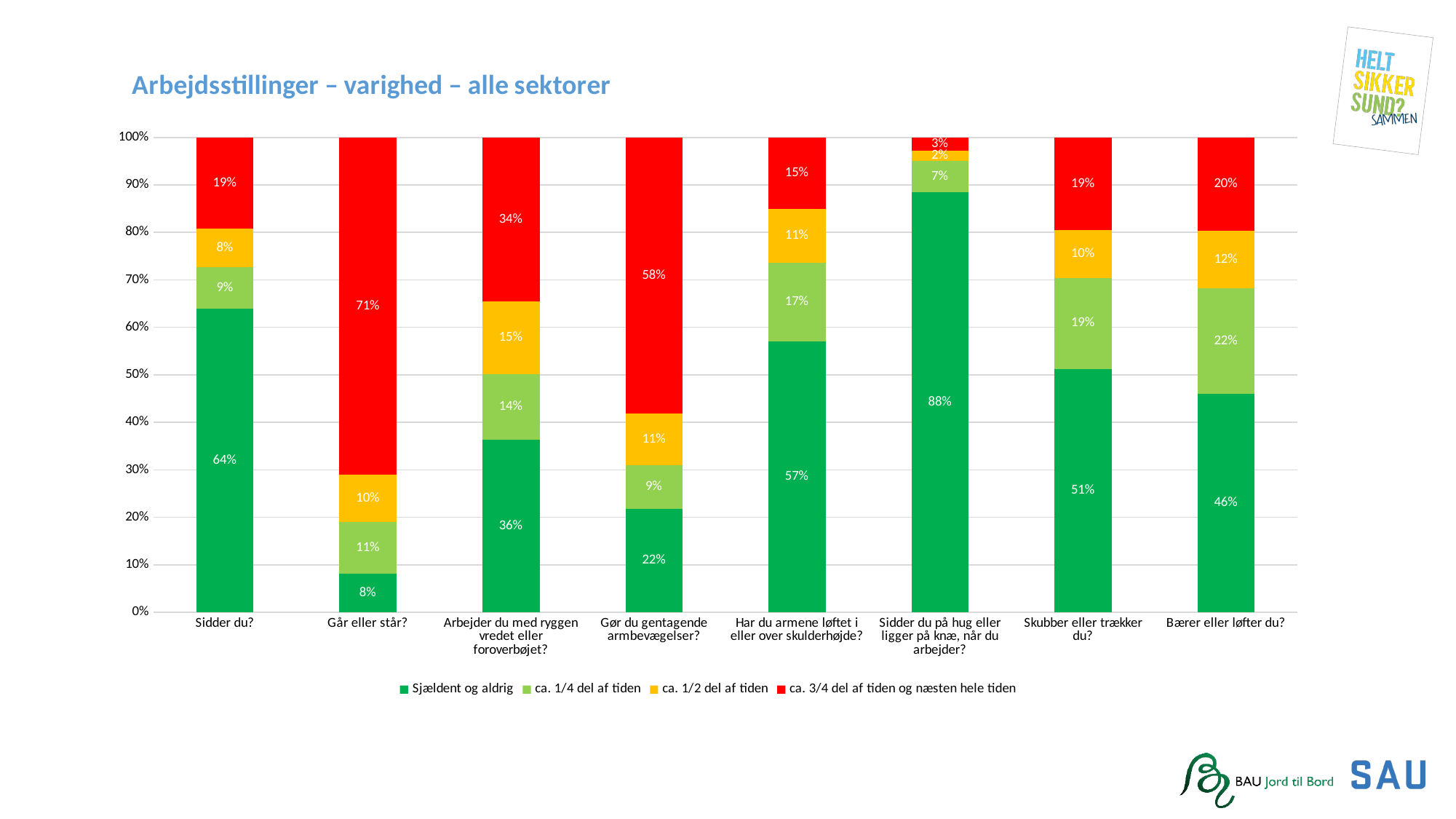
Which colour represents 'ca. 1/2 del af tiden' in the legend? Yellow Which category has the lowest value for 'Sjældent og aldrig'? Går eller står? What is the value of 'ca. 3/4 del af tiden og næsten hele tiden' for 'Går eller står?'? 71% What is the value of 'Sjældent og aldrig' for 'Sidder du?'? 64% How many series does the legend list? 4 Which is larger: the 'ca. 1/4 del af tiden' value for 'Bærer eller løfter du?' or for 'Skubber eller trækker du?'? Bærer eller løfter du? How many categories (questions) are shown along the x axis? 8 Which category has the highest value for 'Sjældent og aldrig'? Sidder du på hug eller ligger på knæ, når du arbejder? What is the title of the chart? Arbejdsstillinger – varighed – alle sektorer What is the difference between the 'ca. 3/4 del af tiden og næsten hele tiden' values for 'Gør du gentagende armbevægelser?' and 'Bærer eller løfter du?'? 38% What is the value of 'ca. 1/2 del af tiden' for 'Arbejder du med ryggen vredet eller foroverbøjet?'? 15% What kind of chart is shown on the slide? Stacked bar chart